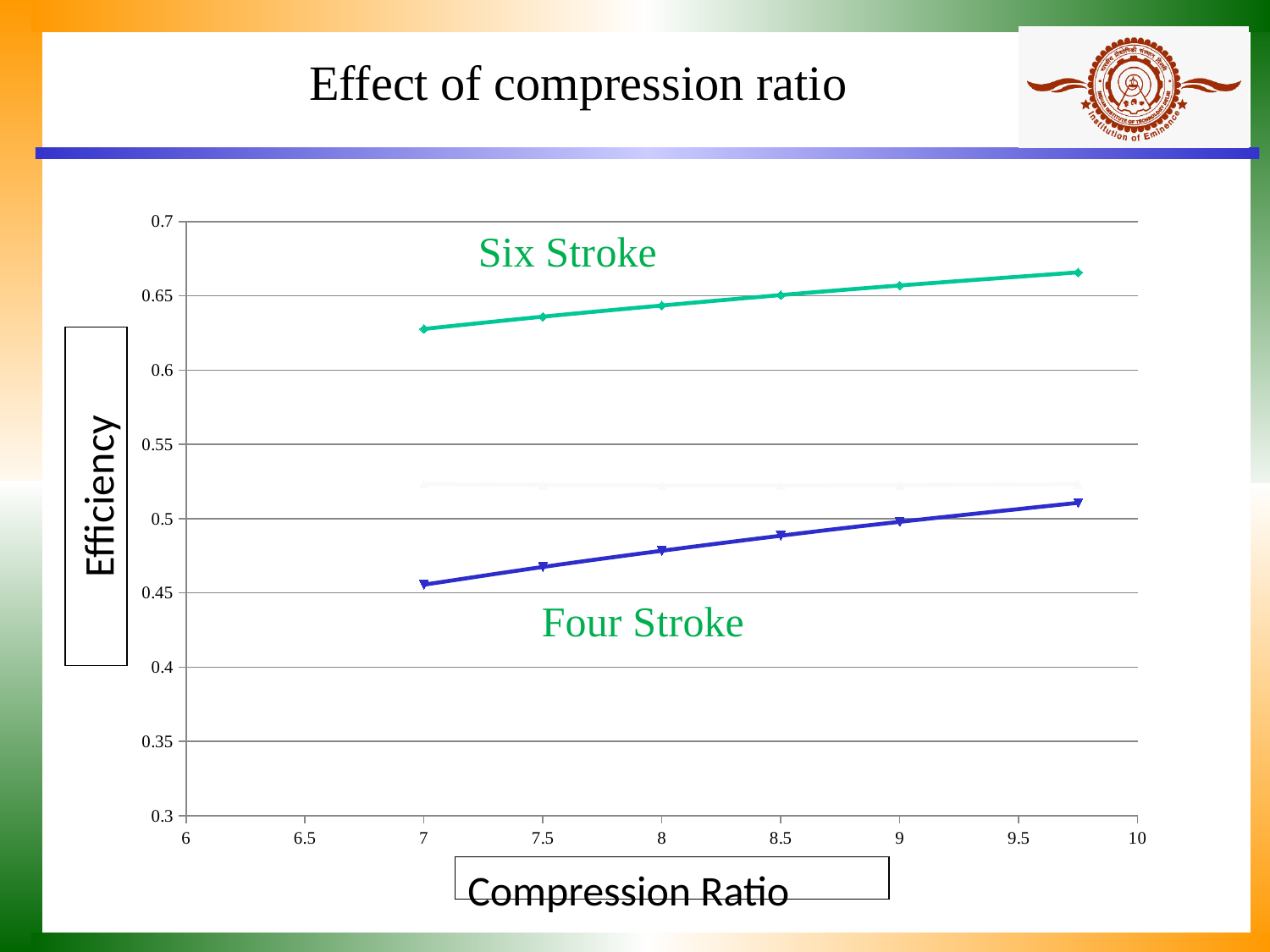
How many data points are plotted for the Six Stroke series? 6 Is the Six Stroke efficiency at a compression ratio of 7 greater or less than 0.6? greater Is the Four Stroke efficiency at a compression ratio of 8 greater or less than 0.5? less Which series has the higher efficiency across the plotted compression ratios, Six Stroke or Four Stroke? Six Stroke Does the efficiency of the Six Stroke series rise or fall as the compression ratio increases? rise Is the Four Stroke efficiency at a compression ratio of 7 greater or less than 0.5? less What is the title of the chart on the slide? Effect of compression ratio Does the efficiency of the Four Stroke series rise or fall as the compression ratio increases? rise What is the label of the vertical axis of the chart? Efficiency What kind of chart is shown on the slide? line chart